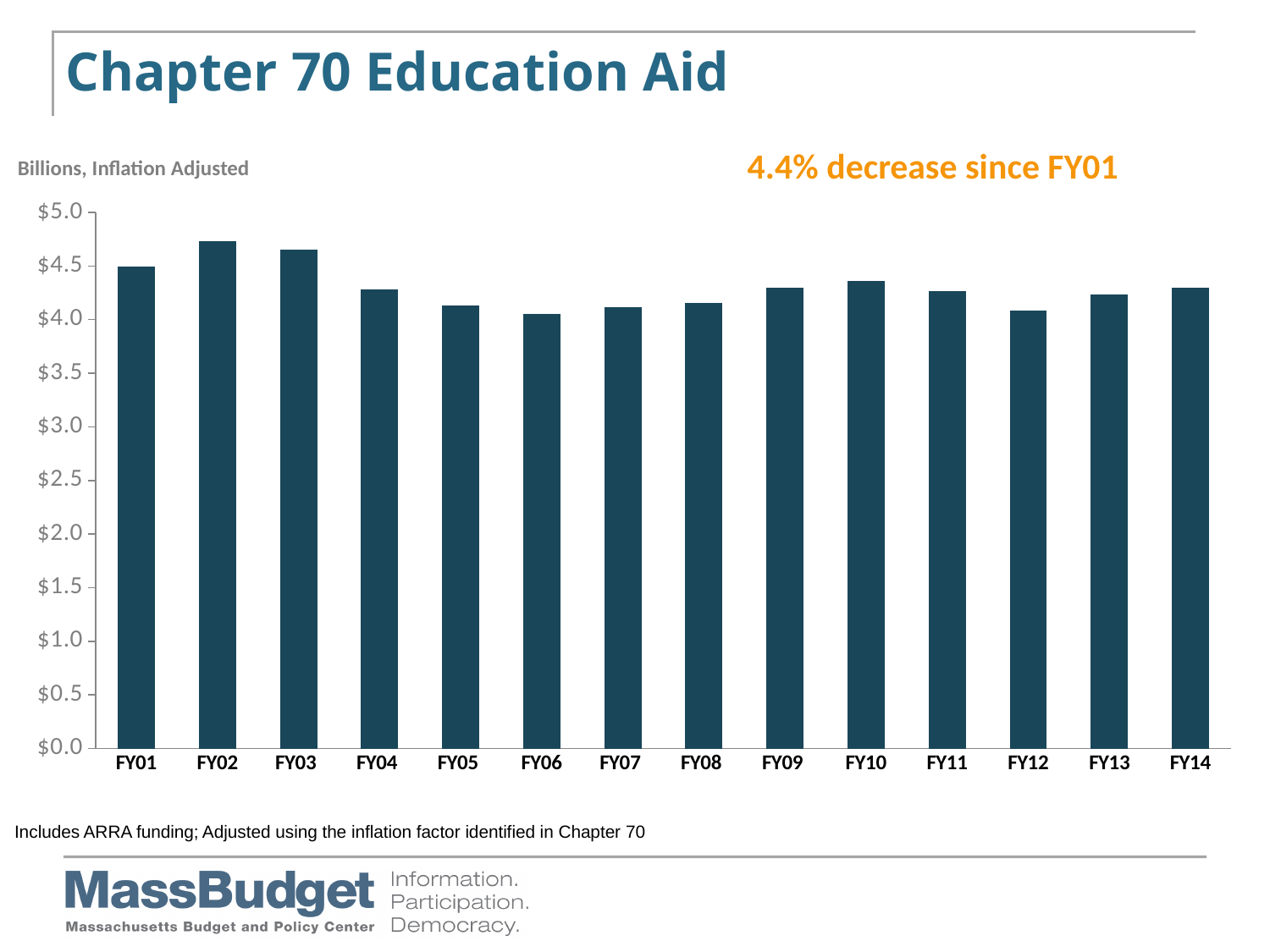
How many fiscal years are plotted on the chart? 14 Is the value for FY05 greater or less than $4.0? greater Overall, do the values rise or fall from FY01 to FY14? fall Which is larger, the value for FY01 or the value for FY14? FY01 Is the value for FY06 greater or less than $4.5? less What is the title of the chart? Chapter 70 Education Aid Is the value for FY02 greater or less than $4.5? greater Which fiscal year has the highest Chapter 70 Education Aid value? FY02 What percentage change since FY01 is noted on the chart? 4.4% decrease What kind of chart is shown on the slide? Bar chart Which is larger, the value for FY02 or the value for FY04? FY02